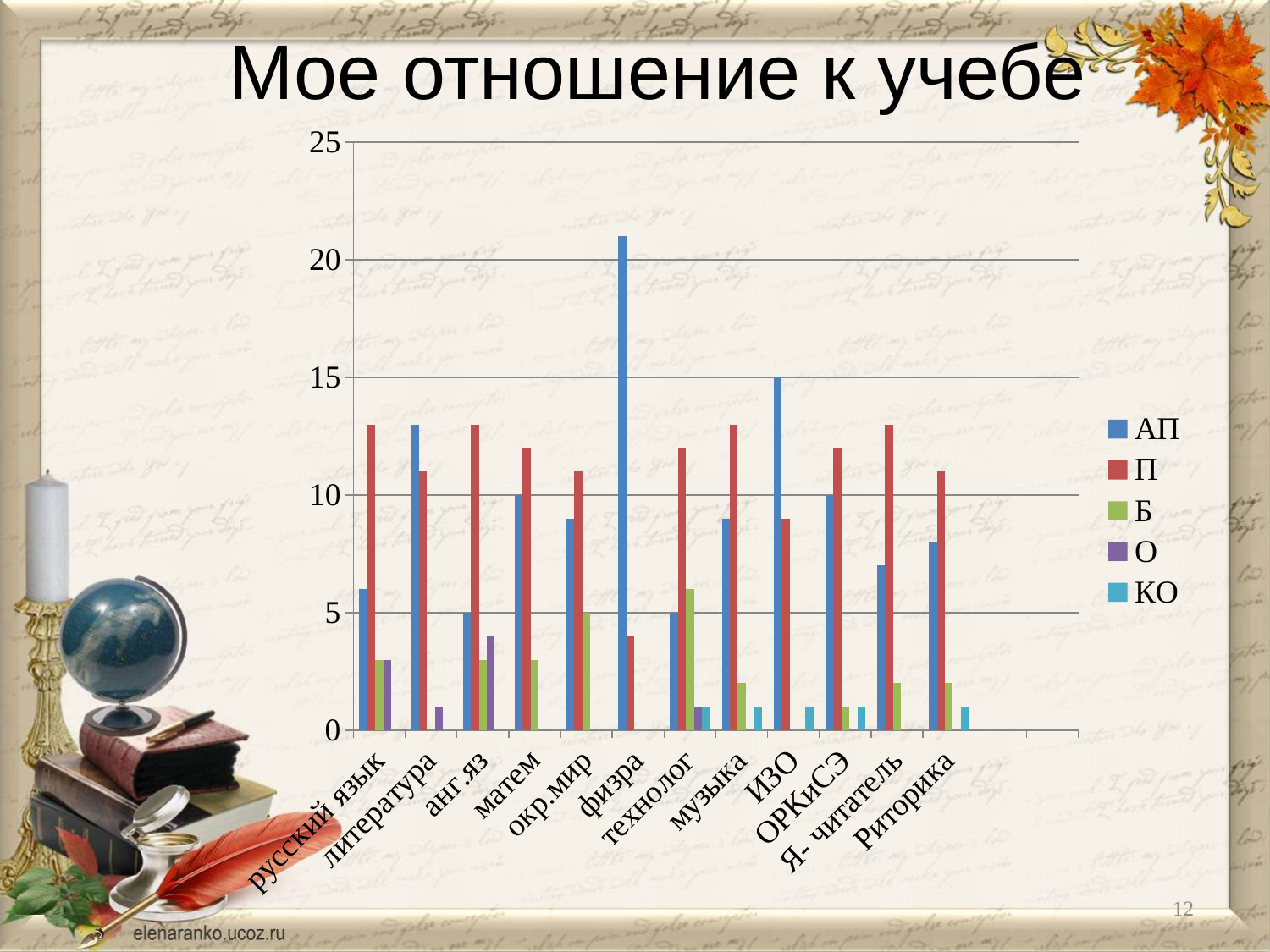
Which category has the highest АП value? физра How many series does the legend list? 5 Is the П value for русский язык greater or less than 10? greater What is the title of the chart? Мое отношение к учебе What kind of chart is shown on the slide? bar chart How many categories are shown on the x axis? 12 Is the П value for физра greater or less than 5? less Is the АП value for физра greater or less than 20? greater For физра, which is larger: the АП value or the П value? АП Which series is listed last in the legend? КО What is the АП value for ИЗО? 15 For русский язык, which is larger: the АП value or the П value? П